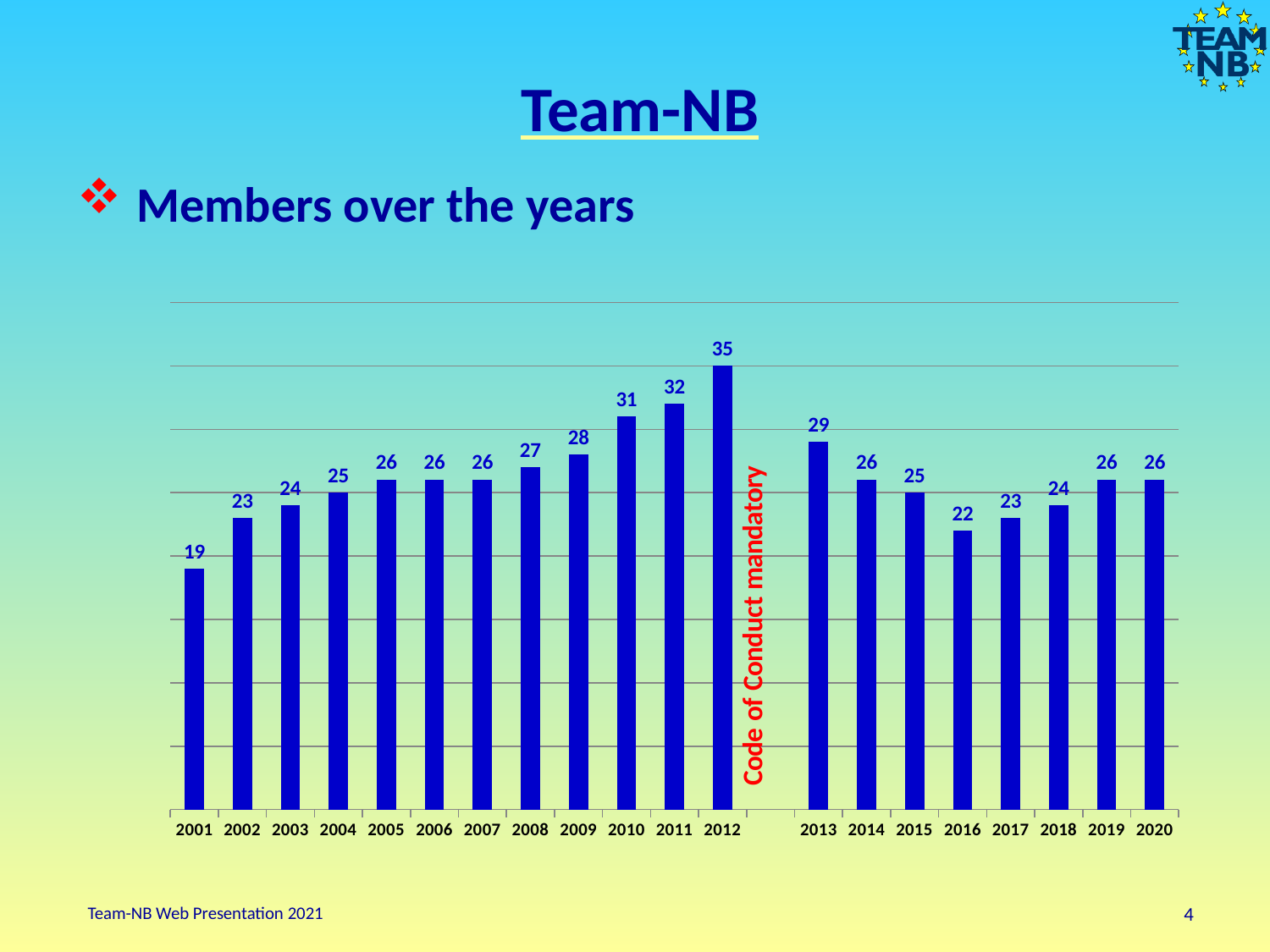
Which year has more members, 2010 or 2013? 2010 How many years are labelled on the x axis? 20 What kind of chart is shown on the slide? Bar chart What is the number of members shown for 2016? 22 What is the difference between the number of members in 2012 and in 2013? 6 What is the number of members shown for 2001? 19 What is the number of members shown for 2020? 26 Which year has the lowest number of members? 2001 What is the number of members shown for 2012? 35 Which year has the highest number of members? 2012 What is the difference between the number of members in 2020 and in 2001? 7 What does the red vertical text between the 2012 and 2013 bars say? Code of Conduct mandatory